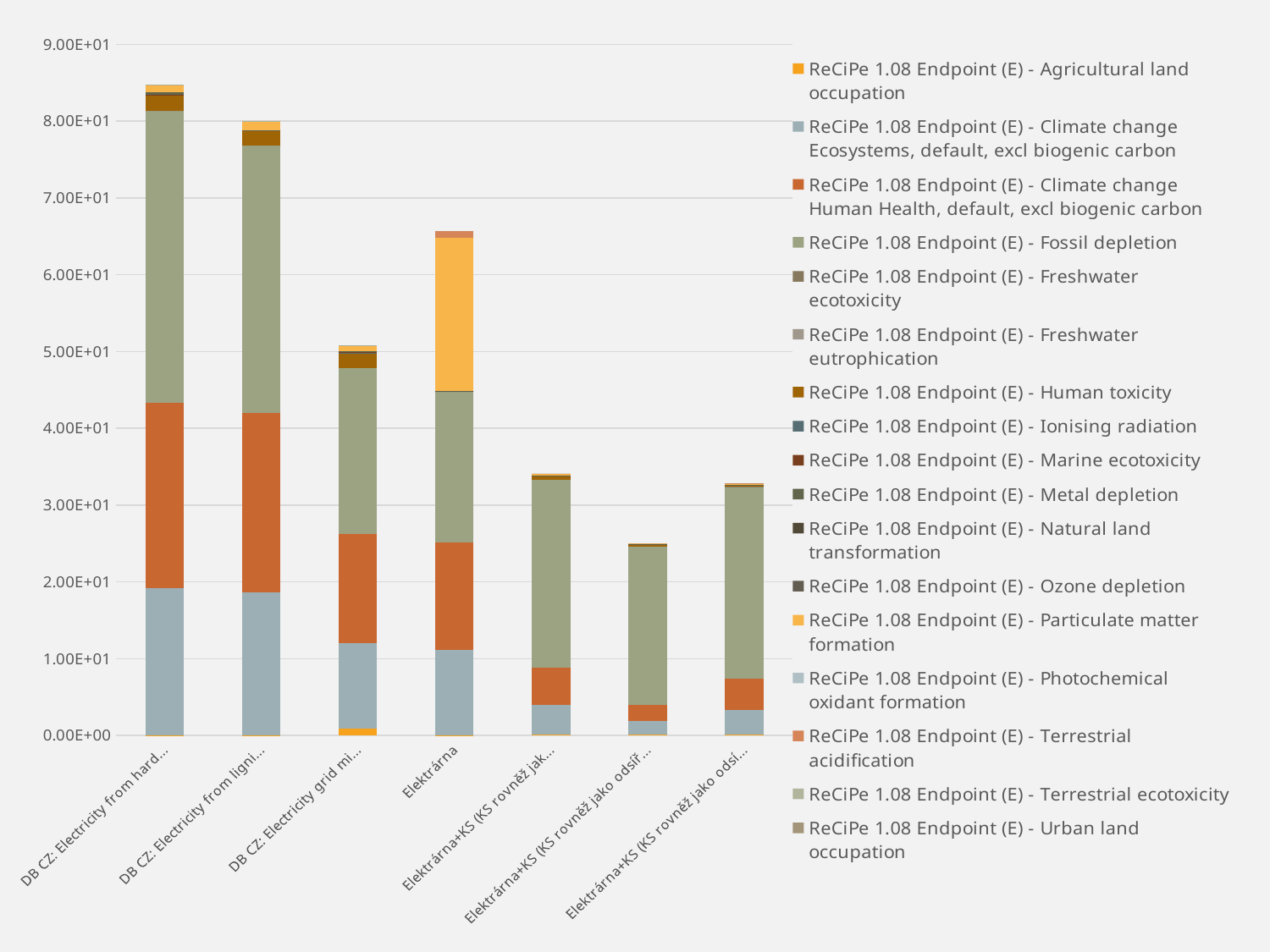
Which bar is taller: DB CZ: Electricity from hard... or DB CZ: Electricity from ligni...? DB CZ: Electricity from hard... Is the total of the third bar (DB CZ: Electricity grid mi...) greater or less than 6.00E+01? less Is the total of the first bar (DB CZ: Electricity from hard...) greater or less than 8.00E+01? greater Where is the legend placed on the slide? To the right of the chart What kind of chart is shown on the slide? Stacked bar chart Which bar is the shortest overall? The sixth bar (Elektrárna+KS (KS rovněž jako odsíř...) Which category has the tallest stacked bar? DB CZ: Electricity from hard... How many bars (categories) are plotted on the x axis? 7 How many series does the legend list? 17 Is the total of the sixth bar greater or less than 3.00E+01? less Which bar is taller: Elektrárna or DB CZ: Electricity grid mi...? Elektrárna